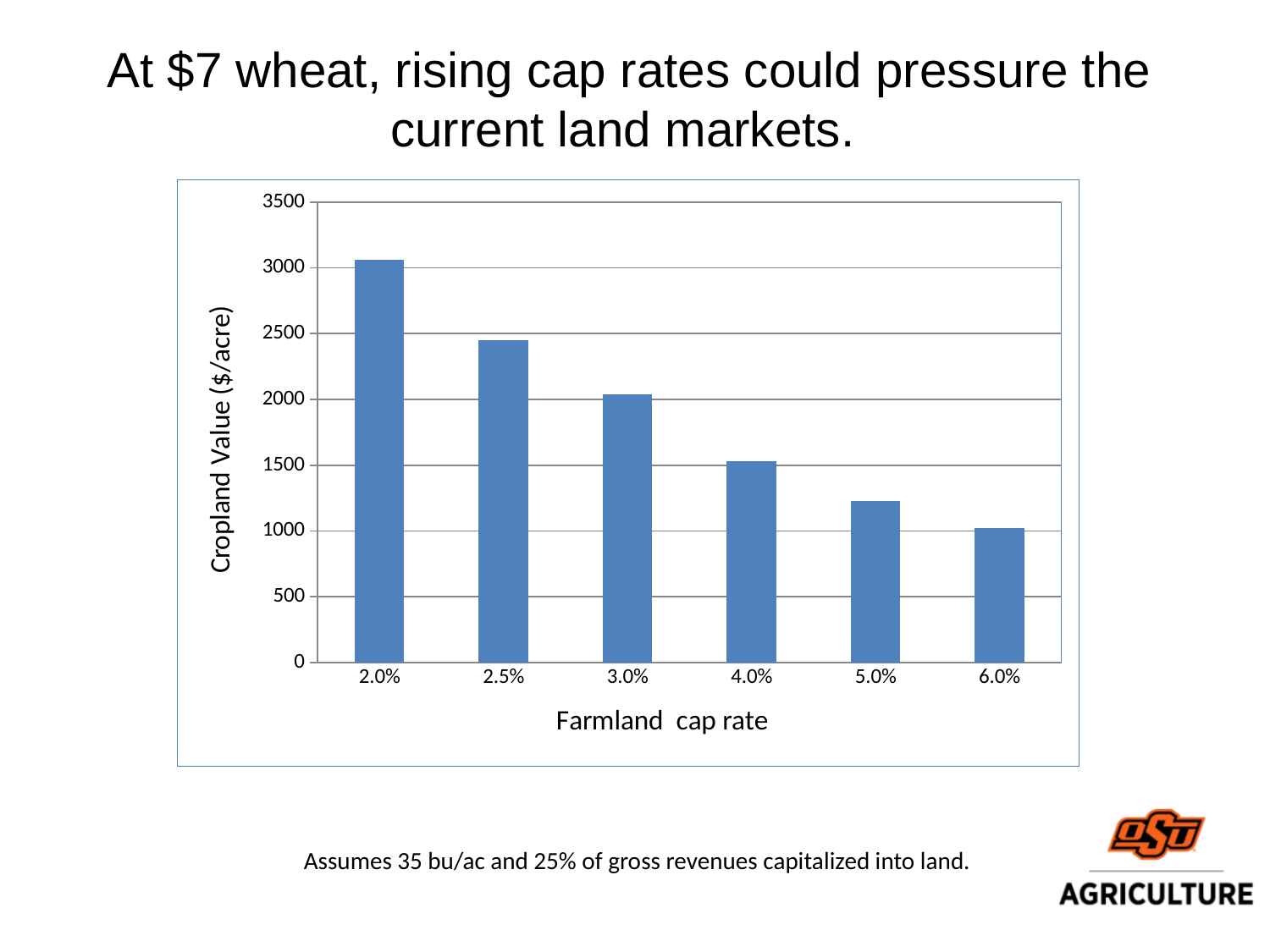
How many farmland cap rate categories are plotted on the chart? 6 Is the cropland value at a 5.0% cap rate greater or less than 1000? greater What is the label of the vertical axis of the chart? Cropland Value ($/acre) Which farmland cap rate has the highest cropland value? 2.0% Is the cropland value at a 2.5% cap rate greater or less than 2000? greater What kind of chart is shown on the slide? bar chart Is the cropland value at a 6.0% cap rate greater or less than 1500? less Do cropland values rise or fall as the farmland cap rate increases along the x axis? fall Which farmland cap rate has the lowest cropland value? 6.0% Which has a larger cropland value, a 3.0% cap rate or a 4.0% cap rate? 3.0%